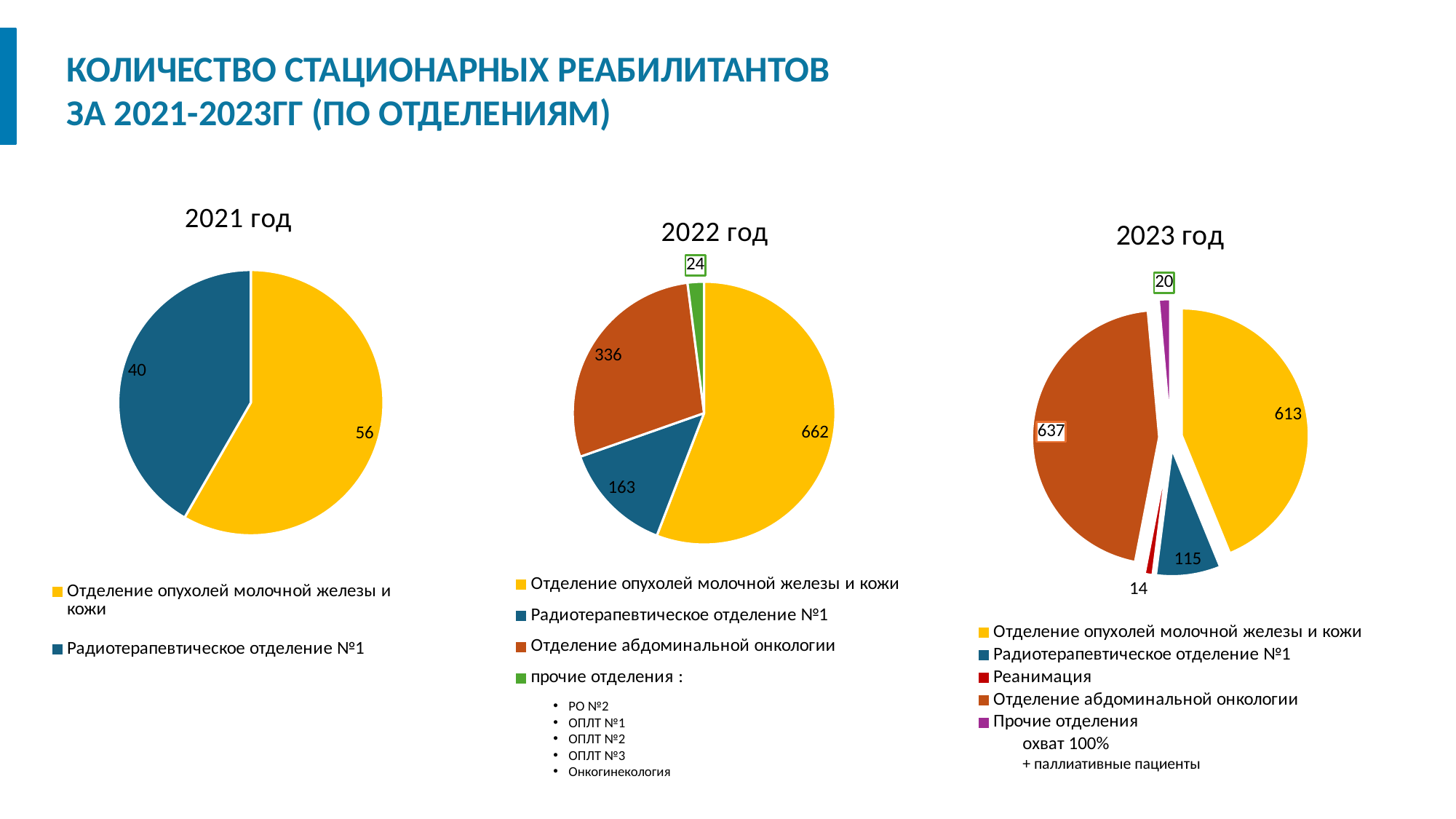
In the 2023 год chart, what colour is the slice for Реанимация? red How many slices does the 2023 год chart have? 5 How many entries does the legend of the 2022 год chart list? 4 In the 2022 год chart, what is the difference between Отделение опухолей молочной железы и кожи and Радиотерапевтическое отделение №1? 499 In the 2023 год chart, which category has the largest value? Отделение абдоминальной онкологии In the 2021 год chart, what is the value for Радиотерапевтическое отделение №1? 40 In the 2022 год chart, which category has the smallest value? прочие отделения In the 2023 год chart, what is the value for Реанимация? 14 In the 2022 год chart, what is the value for Отделение абдоминальной онкологии? 336 In the 2023 год chart, which is larger: Радиотерапевтическое отделение №1 or Прочие отделения? Радиотерапевтическое отделение №1 What kind of chart is the 2021 год chart? pie chart What is the total of all slices in the 2021 год chart? 96